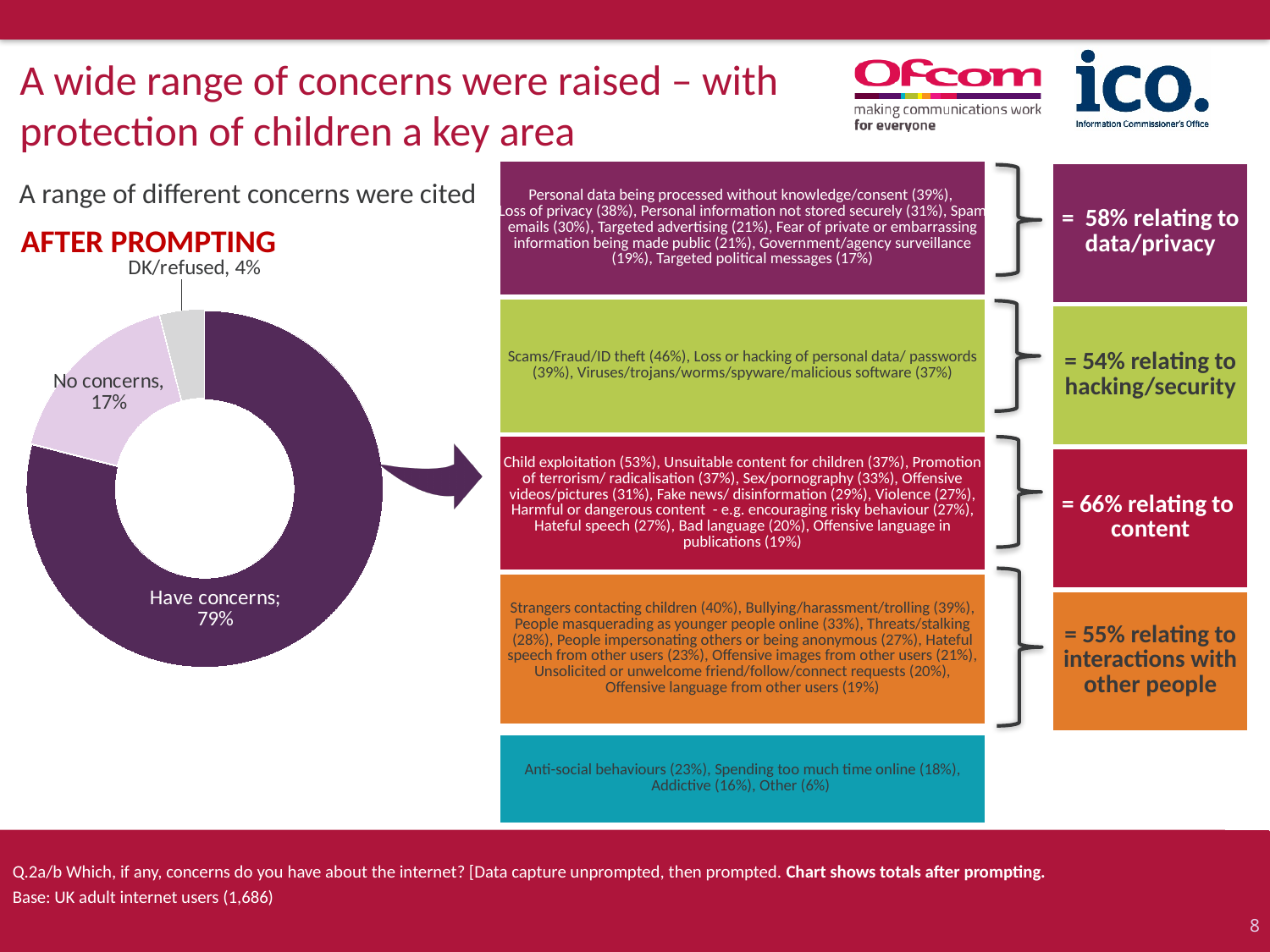
What kind of chart is shown on the left of the slide? Pie chart (donut) What is the difference in percentage points between 'Have concerns' and 'No concerns'? 62 What is the heading shown in red above the pie chart? AFTER PROMPTING What share of respondents answered DK/refused? 4% What share of respondents said they have no concerns? 17% Which slice of the pie chart is the largest? Have concerns What is the combined share of 'No concerns' and 'DK/refused'? 21% How many slices does the pie chart have? 3 What is the base size stated for the chart? UK adult internet users (1,686) Which slice of the pie chart is the smallest? DK/refused Which is larger: the share for 'No concerns' or the share for 'DK/refused'? No concerns What share of respondents said they have concerns about the internet? 79%